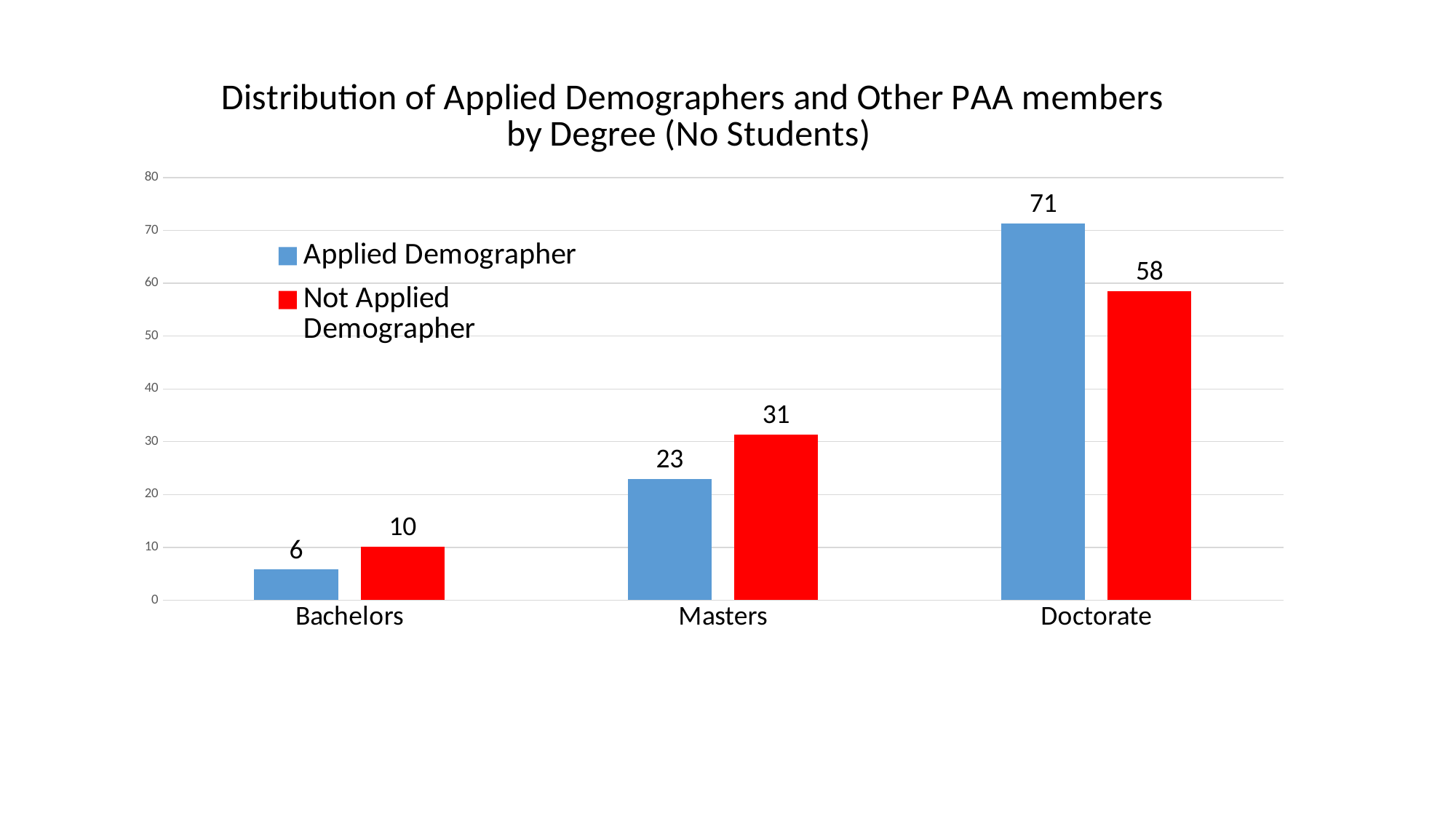
At the Bachelors level, which series has the larger value, Applied Demographer or Not Applied Demographer? Not Applied Demographer How many series does the legend list? 2 What is the value for Applied Demographer at the Doctorate level? 71 What is the value for Not Applied Demographer at the Masters level? 31 What is the value for Applied Demographer at the Bachelors level? 6 Do the Applied Demographer values rise or fall from Bachelors to Doctorate? Rise Which degree level has the lowest value for Applied Demographer? Bachelors What kind of chart is shown on the slide? Bar chart How many degree categories are shown on the x axis? 3 What is the difference between Not Applied Demographer and Applied Demographer at the Masters level? 8 Which degree level has the highest value for Not Applied Demographer? Doctorate What is the difference between Applied Demographer and Not Applied Demographer at the Doctorate level? 13